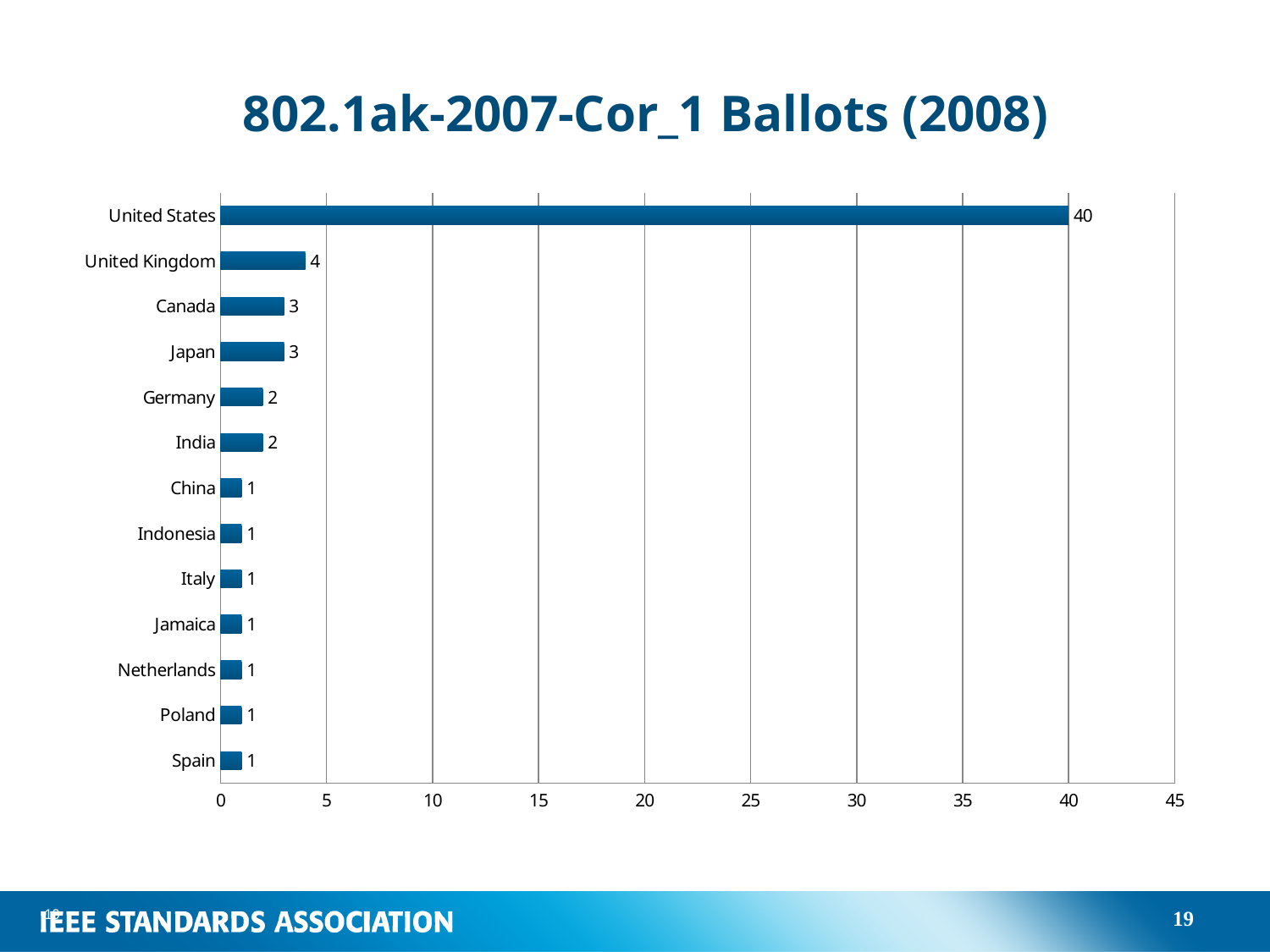
How many countries are shown in the chart? 13 Is the value for United States greater or less than 35? greater What is the difference between the values for Canada and Germany? 1 What is the value for United Kingdom? 4 What is the title of the chart? 802.1ak-2007-Cor_1 Ballots (2008) What is the value for United States? 40 Which country has the highest value? United States Which is larger, the value for United Kingdom or the value for Canada? United Kingdom What is the value for India? 2 What is the value for Japan? 3 What is the difference between the values for United States and United Kingdom? 36 What kind of chart is shown on the slide? bar chart